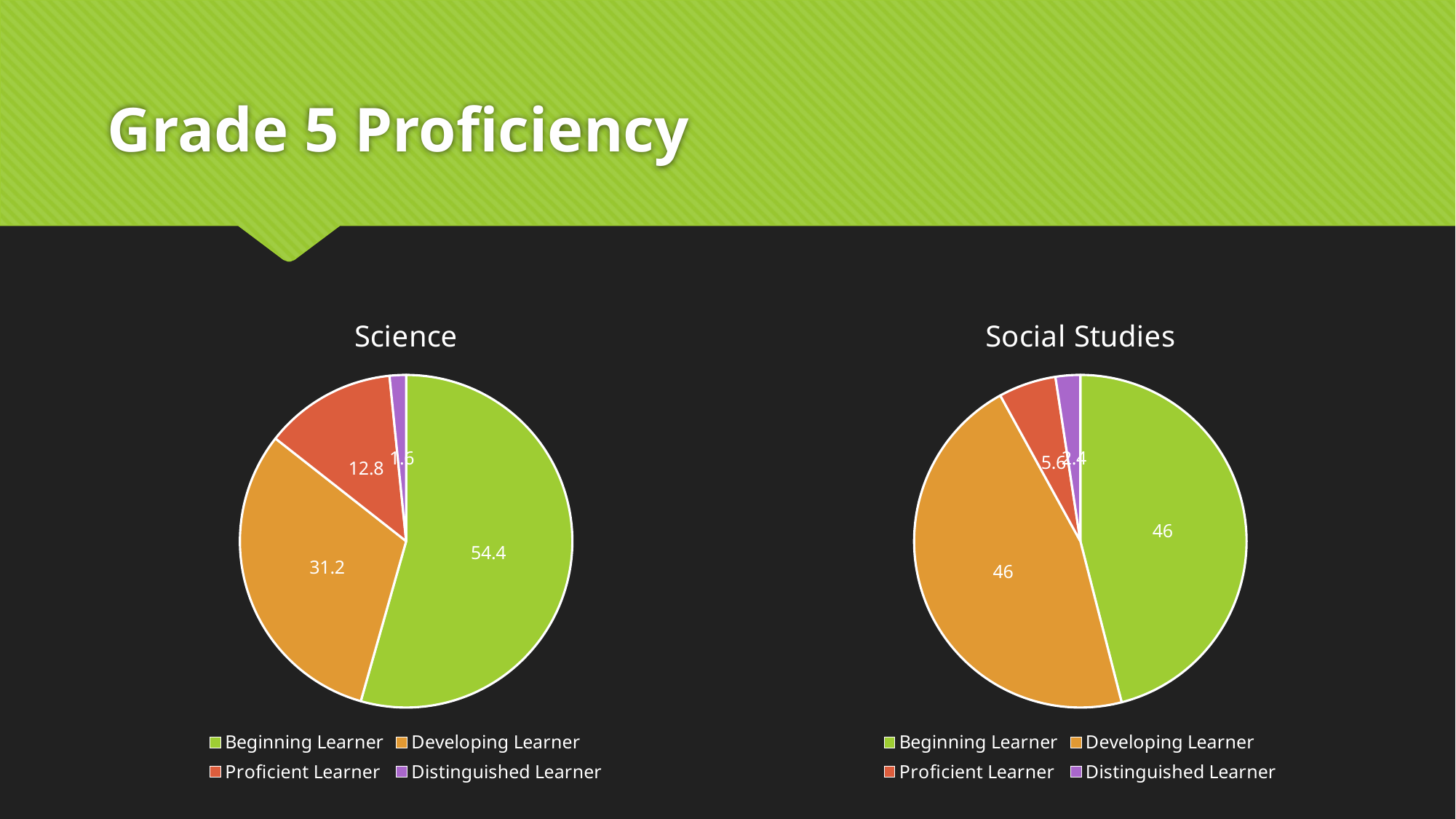
In the Science pie chart, which is larger, Proficient Learner or Distinguished Learner? Proficient Learner In the Social Studies pie chart, what is the difference between the Proficient Learner and Distinguished Learner values? 3.2 In the Social Studies pie chart, which category has the smallest slice? Distinguished Learner In the Science pie chart, what is the value for Proficient Learner? 12.8 In the Social Studies pie chart, what is the value for Proficient Learner? 5.6 How many categories does the legend of the Social Studies pie chart list? 4 In the Science pie chart, which category has the smallest slice? Distinguished Learner In the Science pie chart, what is the value for Developing Learner? 31.2 In the Science pie chart, what is the value for Beginning Learner? 54.4 In the Social Studies pie chart, what is the value for Distinguished Learner? 2.4 In the Science pie chart, which category has the largest slice? Beginning Learner In the Science pie chart, what is the difference between the Beginning Learner and Developing Learner values? 23.2